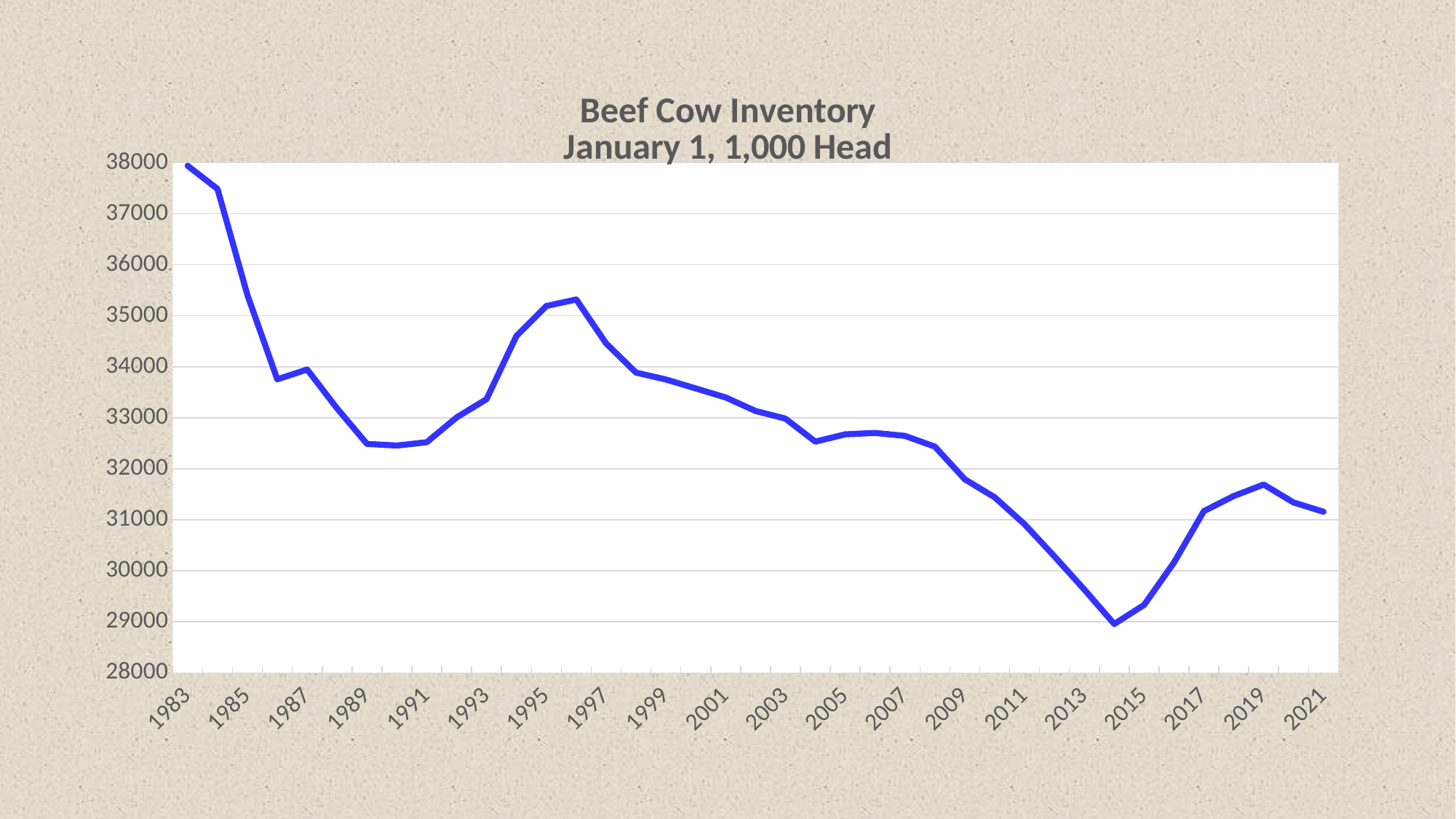
What is the title of the chart? Beef Cow Inventory January 1, 1,000 Head What kind of chart is shown on the slide? line chart In which year is the beef cow inventory highest? 1983 Is the value for 2014 greater or less than 30000? less Is the value for 1999 greater or less than 33000? greater What colour is the line in the chart? blue Overall, does the beef cow inventory rise or fall from 1983 to 2021? fall In which year is the beef cow inventory lowest? 2014 Is the value for 1983 greater or less than 37000? greater Which year has the larger beef cow inventory, 2014 or 2019? 2019 Which year has the larger beef cow inventory, 1996 or 2006? 1996